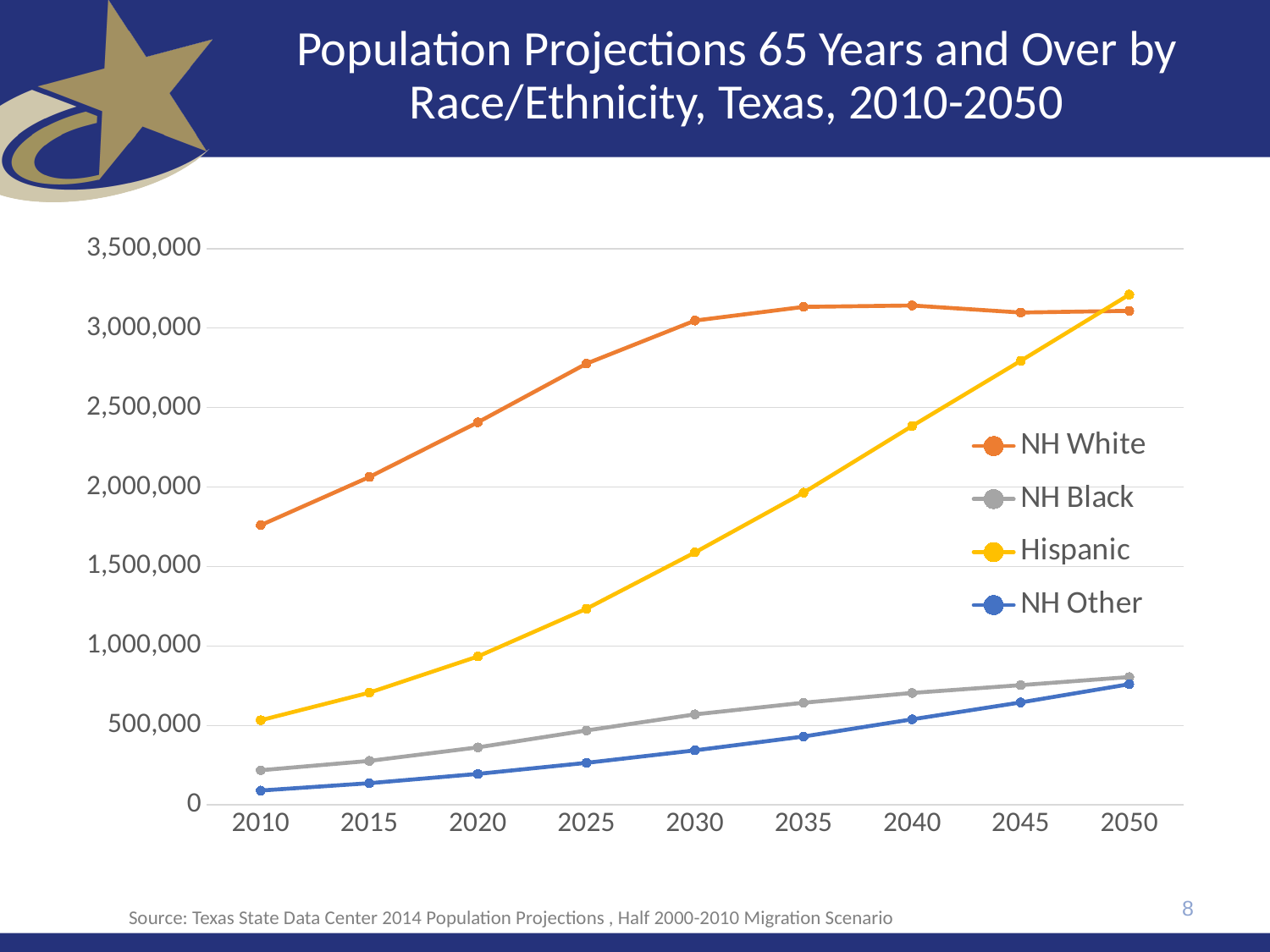
Is the value for Hispanic in 2030 greater or less than 1,500,000? greater Does the Hispanic line rise or fall from 2010 to 2050? rise Is the value for Hispanic in 2020 greater or less than 1,000,000? less Which race/ethnicity group has the highest projected population 65 and over in 2010? NH White How many series does the legend list? 4 Which race/ethnicity group has the highest projected population 65 and over in 2050? Hispanic Is the value for NH White in 2035 greater or less than 3,000,000? greater In 2030, which is larger, the value for NH Black or the value for NH Other? NH Black What kind of chart is shown on the slide? line chart How many years are shown along the x axis? 9 Which race/ethnicity group has the lowest projected population 65 and over in 2010? NH Other